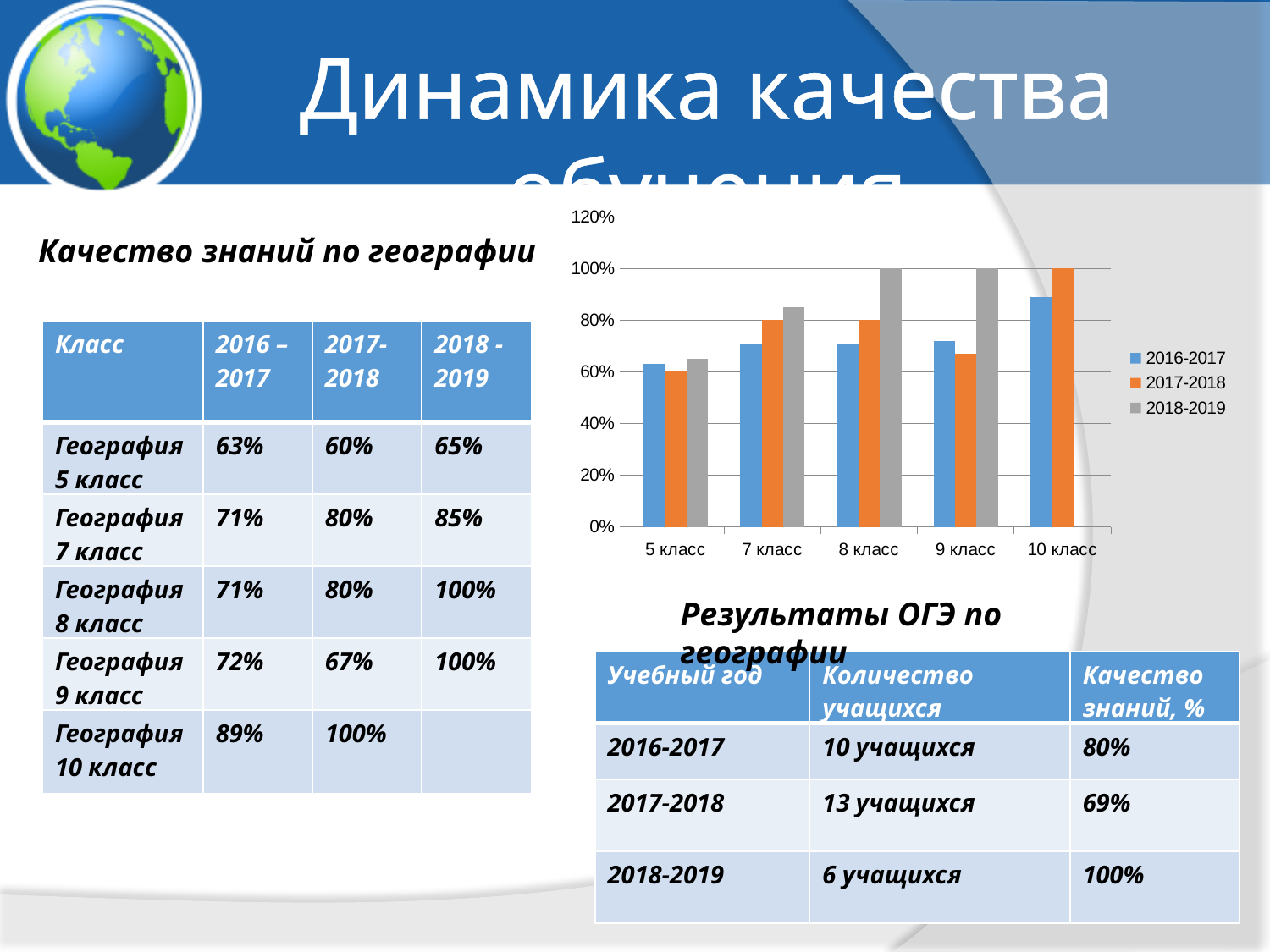
Is the 2016-2017 value for 5 класс greater or less than 80%? less Is the 2016-2017 value for 10 класс greater or less than 80%? greater What kind of chart is shown on the slide? bar chart What is the 2017-2018 value for 7 класс in the chart? 80% What is the 2017-2018 value for 10 класс in the chart? 100% Which class has the lowest 2017-2018 value in the chart? 5 класс How many class categories are shown on the x axis of the chart? 5 In the 2018-2019 series, which is larger: 7 класс or 8 класс? 8 класс What is the difference between the 2017-2018 values for 10 класс and 7 класс? 20% How many series does the chart legend list? 3 What is the 2018-2019 value for 8 класс in the chart? 100% Which class has the highest 2016-2017 value in the chart? 10 класс